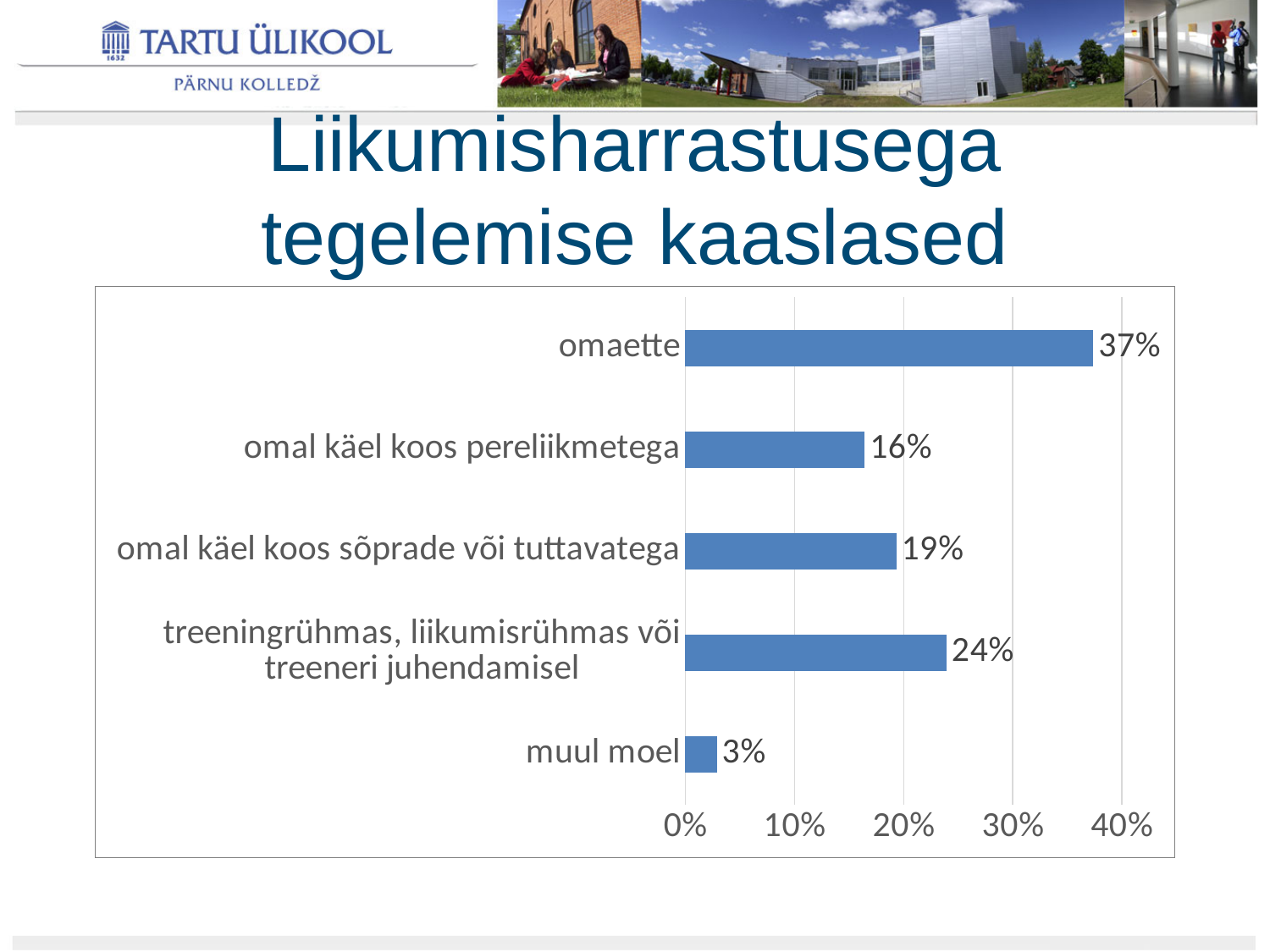
What is the title of the slide containing the chart? Liikumisharrastusega tegelemise kaaslased What is the value for "muul moel"? 3% Which category has the lowest value? muul moel What is the difference between the values for "omaette" and "omal käel koos sõprade või tuttavatega"? 18% Is the value for "treeningrühmas, liikumisrühmas või treeneri juhendamisel" greater or less than 20%? greater Which is larger: the value for "omal käel koos pereliikmetega" or "omal käel koos sõprade või tuttavatega"? omal käel koos sõprade või tuttavatega Which category has the highest value? omaette What is the value for "omaette"? 37% How many categories are shown in the chart? 5 What kind of chart is shown on the slide? bar chart What is the value for "treeningrühmas, liikumisrühmas või treeneri juhendamisel"? 24% What is the value for "omal käel koos pereliikmetega"? 16%